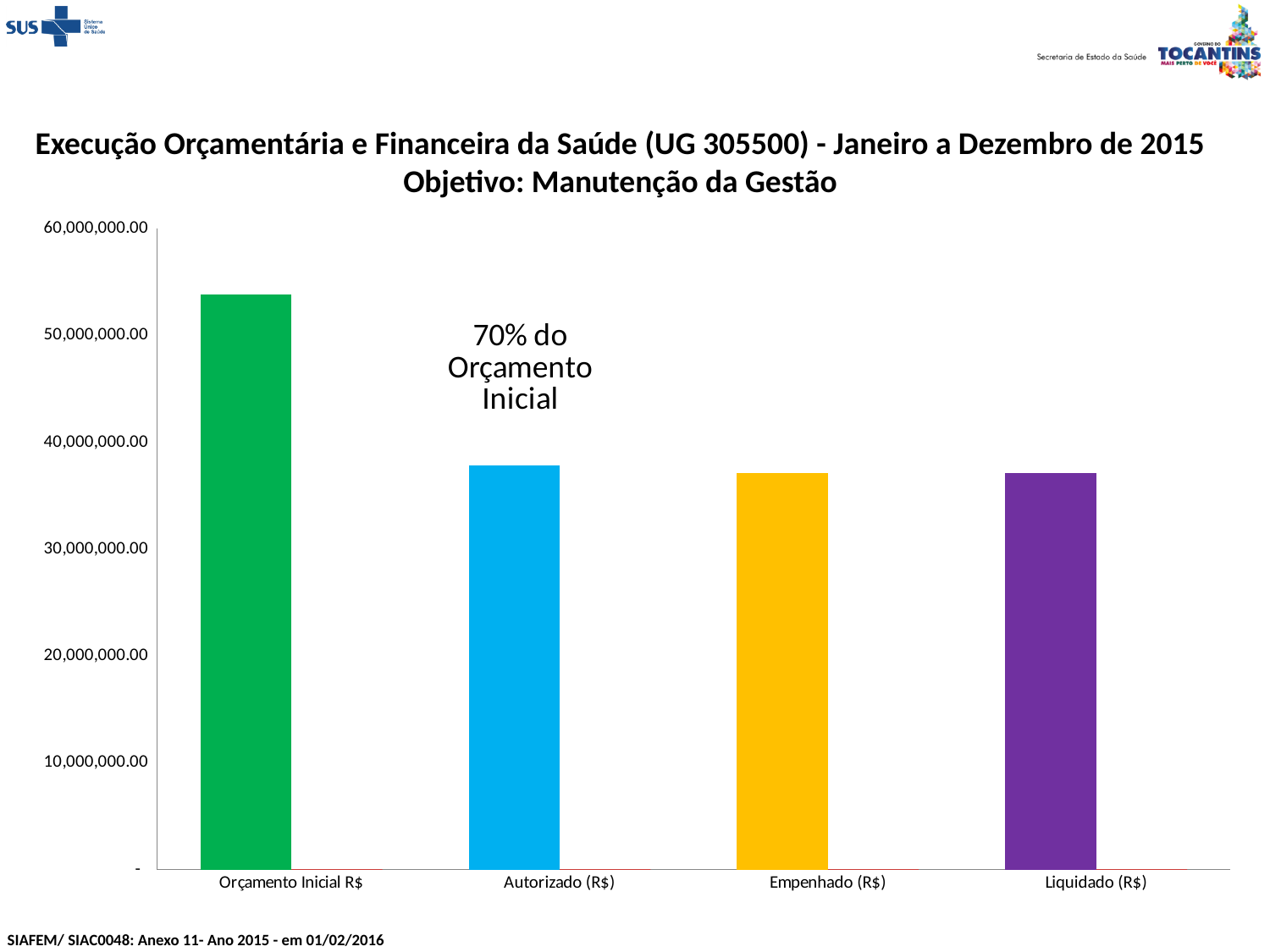
Is the value for Liquidado (R$) greater or less than 40,000,000.00? less What kind of chart is shown on the slide? bar chart Is the value for Empenhado (R$) greater or less than 30,000,000.00? greater Which is larger, the value for Orçamento Inicial R$ or the value for Autorizado (R$)? Orçamento Inicial R$ Is the value for Orçamento Inicial R$ greater or less than 50,000,000.00? greater Do the values rise or fall from the first category to the last along the x axis? fall Which category has the highest value? Orçamento Inicial R$ What colour is the bar for Orçamento Inicial R$? green Which is larger, the value for Liquidado (R$) or the value for Orçamento Inicial R$? Orçamento Inicial R$ What does the text annotation placed above the Autorizado (R$) bar say? 70% do Orçamento Inicial How many categories are plotted on the x axis? 4